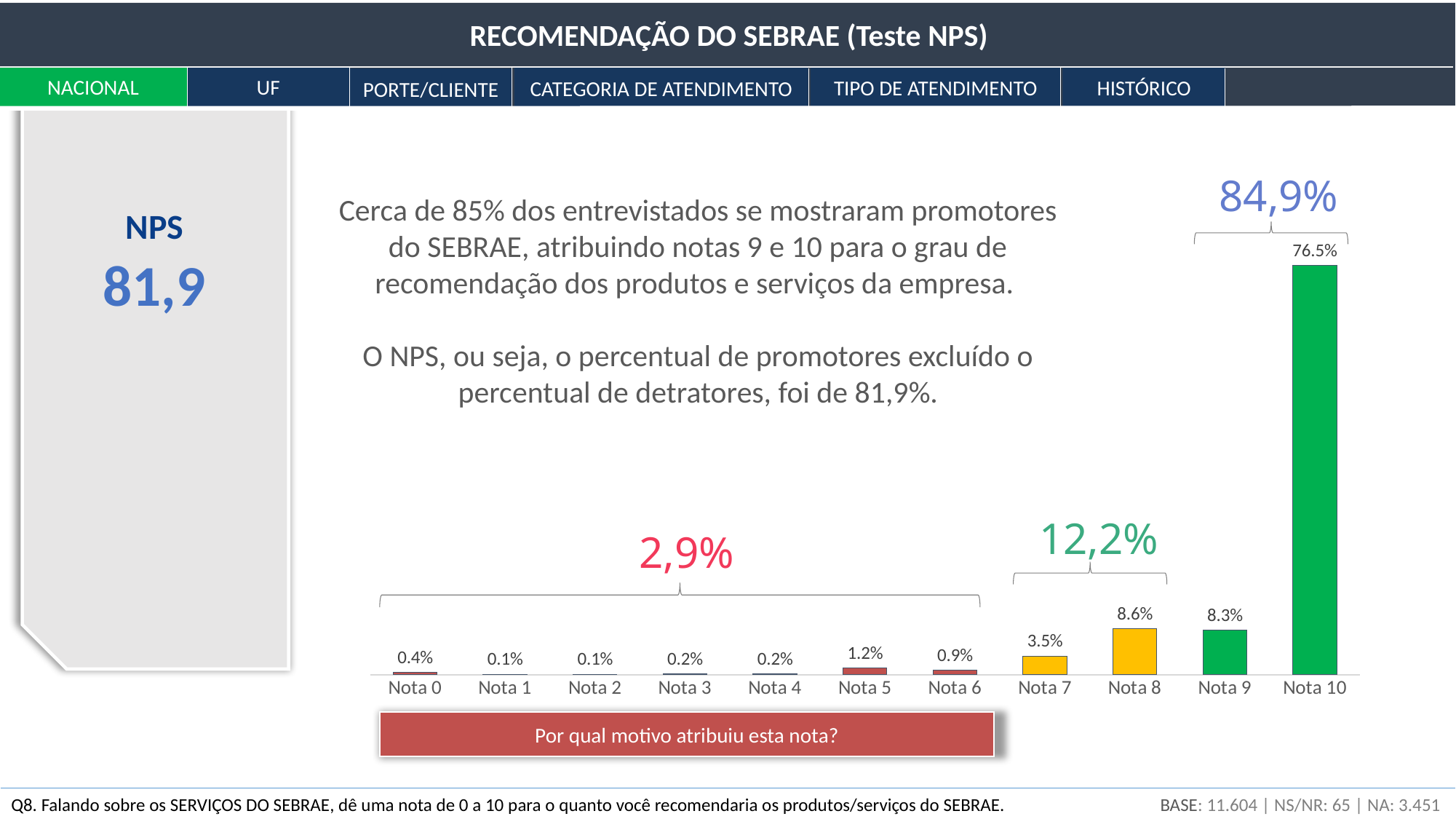
Which is larger, the value for Nota 5 or the value for Nota 6? Nota 5 What is the difference between the values for Nota 8 and Nota 7? 5.1% Which category has the highest value? Nota 10 What is the value for Nota 7? 3.5% What combined percentage is shown above the bracket covering Nota 9 and Nota 10? 84,9% What is the value for Nota 5? 1.2% What is the value for Nota 8? 8.6% What kind of chart is shown on the slide? Bar chart What is the value for Nota 10? 76.5% How many categories (notas) are shown on the x axis? 11 What combined percentage is shown above the bracket covering Nota 7 and Nota 8? 12,2% What is the difference between the values for Nota 10 and Nota 9? 68.2%